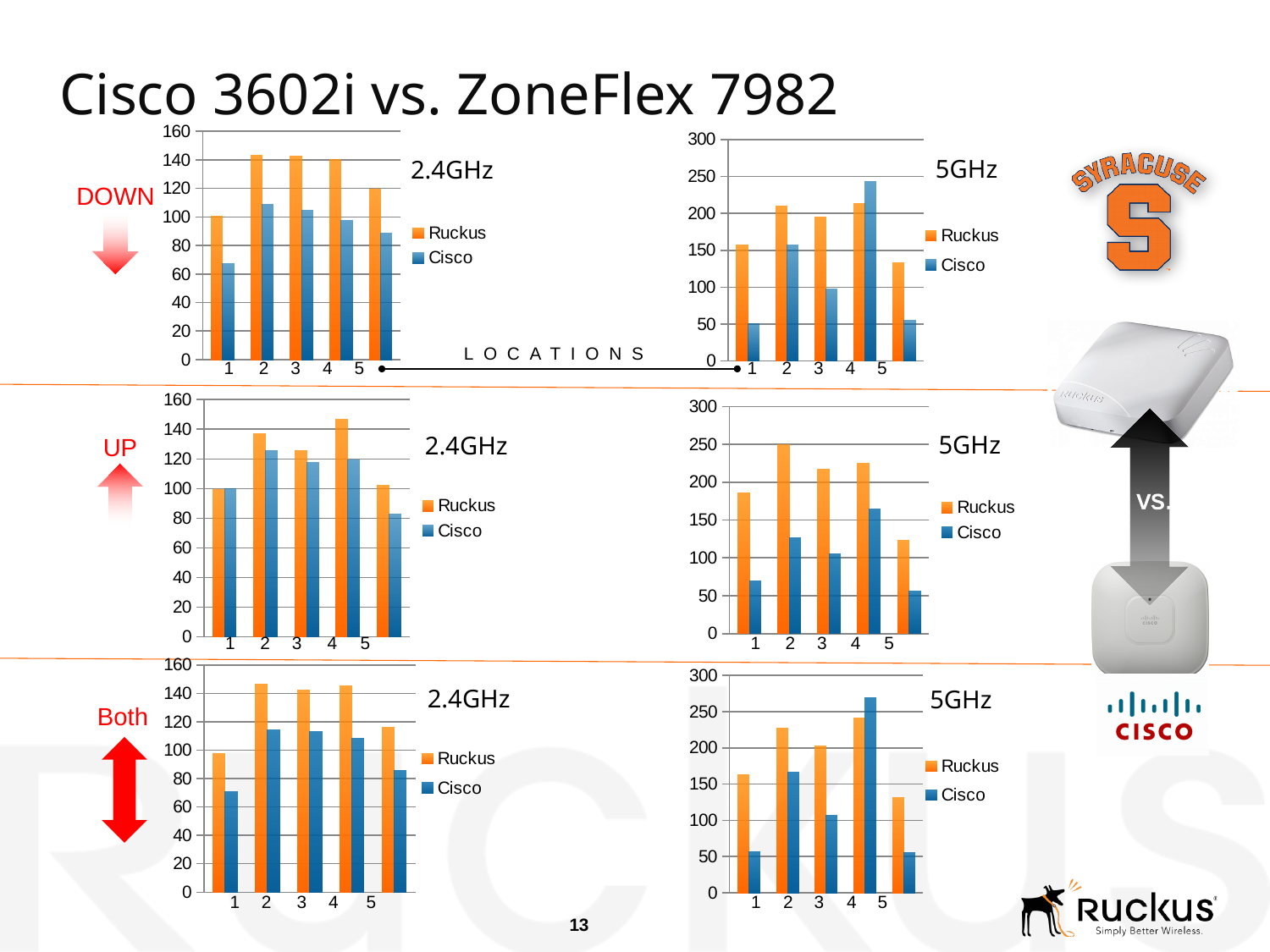
In the UP 2.4GHz chart (middle-left), which location has the highest Ruckus value? 4 In the DOWN 5GHz chart (top-right), which location has the highest Cisco value? 4 In the Both 2.4GHz chart (bottom-left), is the Ruckus value at location 2 greater or less than 140? greater In the DOWN 5GHz chart (top-right), is the Cisco value at location 4 greater or less than 200? greater How many series does the legend of the DOWN 5GHz chart (top-right) list? 2 What kind of chart is the UP 5GHz chart (middle-right)? bar chart In the DOWN 2.4GHz chart (top-left), which location has the lowest Ruckus value? 1 In the UP 2.4GHz chart (middle-left), which location has the lowest Cisco value? 5 How many locations are plotted on the x axis of the Both 2.4GHz chart (bottom-left)? 5 In the Both 5GHz chart (bottom-right), at location 4, which series has the larger value, Ruckus or Cisco? Cisco In the UP 5GHz chart (middle-right), is the Ruckus value at location 5 greater or less than 150? less In the UP 5GHz chart (middle-right), which location has the highest Ruckus value? 2